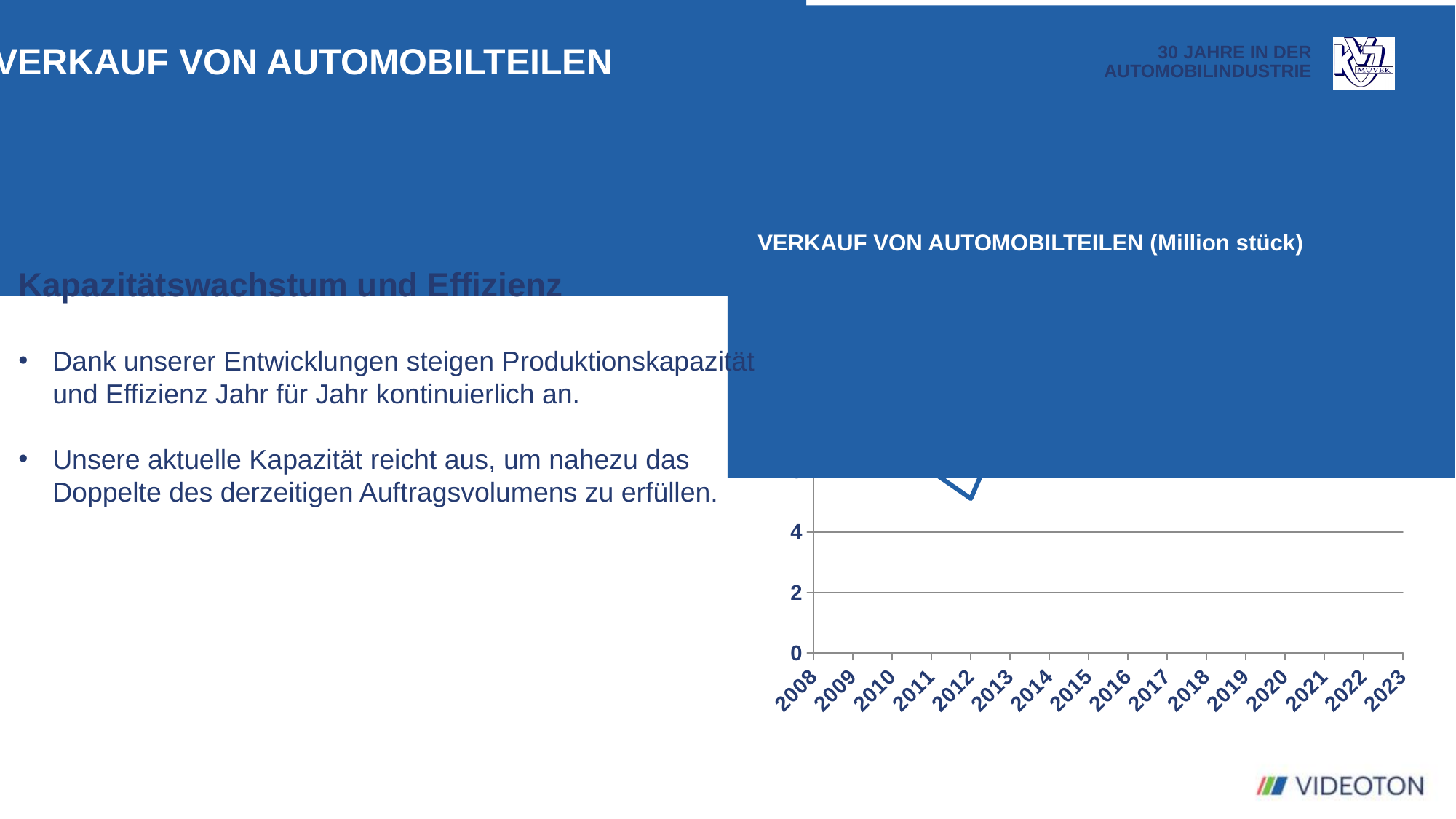
What is the title of the chart on the slide? VERKAUF VON AUTOMOBILTEILEN (Million stück) What kind of chart is shown on the slide? line chart What is the first year shown on the x axis of the chart? 2008 What unit is given in the chart title? Million stück Is the value for 2012 greater or less than 4? greater What is the last year shown on the x axis of the chart? 2023 How many years are listed on the x axis of the chart? 16